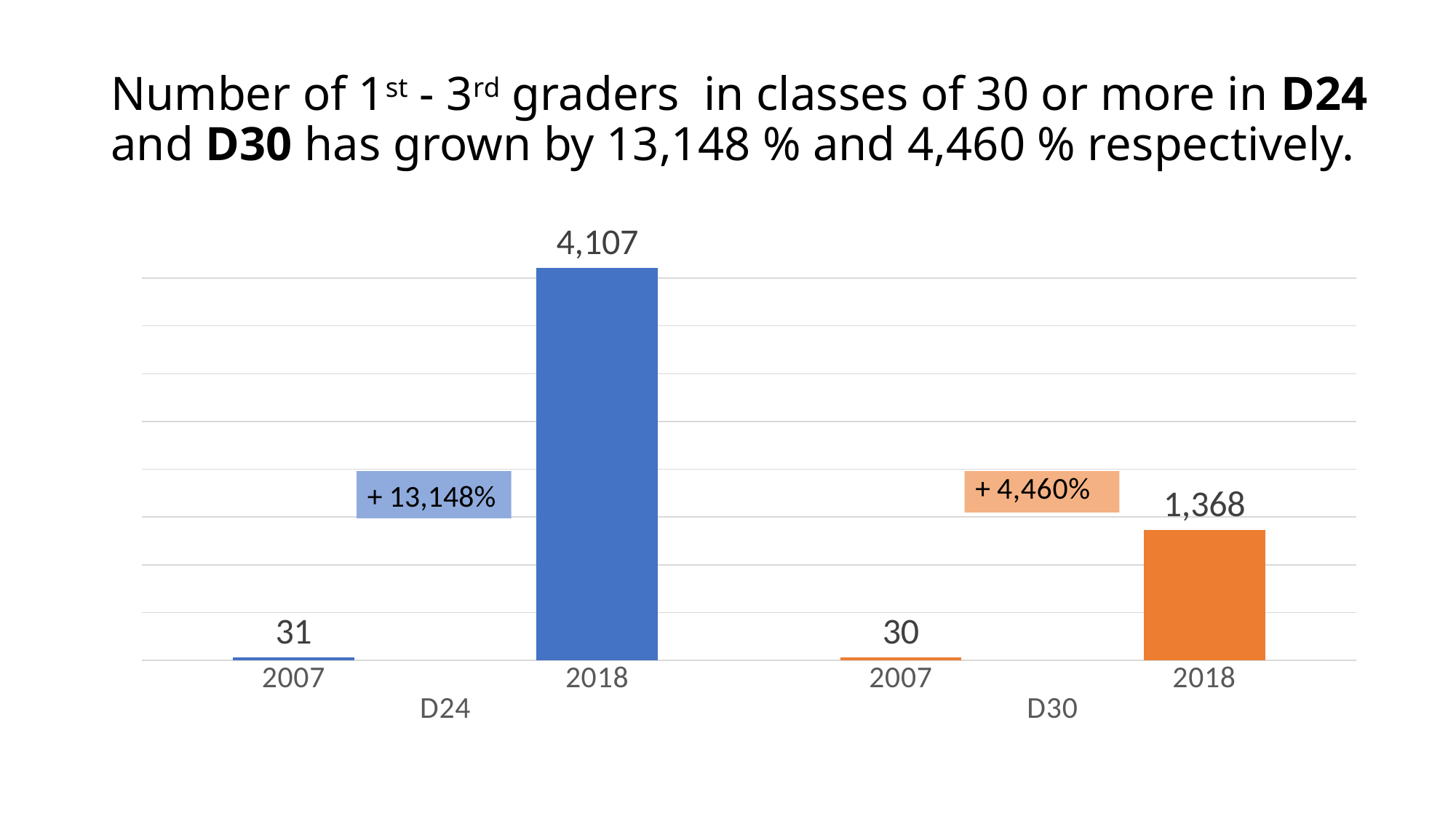
What percentage growth is labelled for D30? + 4,460% What is the value for D30 in 2018? 1,368 What is the difference between the D30 2018 value and the D30 2007 value? 1,338 How many bars are plotted in the chart? 4 Which bar has the highest value? D24 2018 Which is larger, the 2018 value for D24 or the 2018 value for D30? D24 What is the value for D24 in 2007? 31 What kind of chart is shown on the slide? Bar chart What is the value for D24 in 2018? 4,107 Which bar has the lowest value? D30 2007 What is the difference between the D24 2018 value and the D30 2018 value? 2,739 What is the value for D30 in 2007? 30